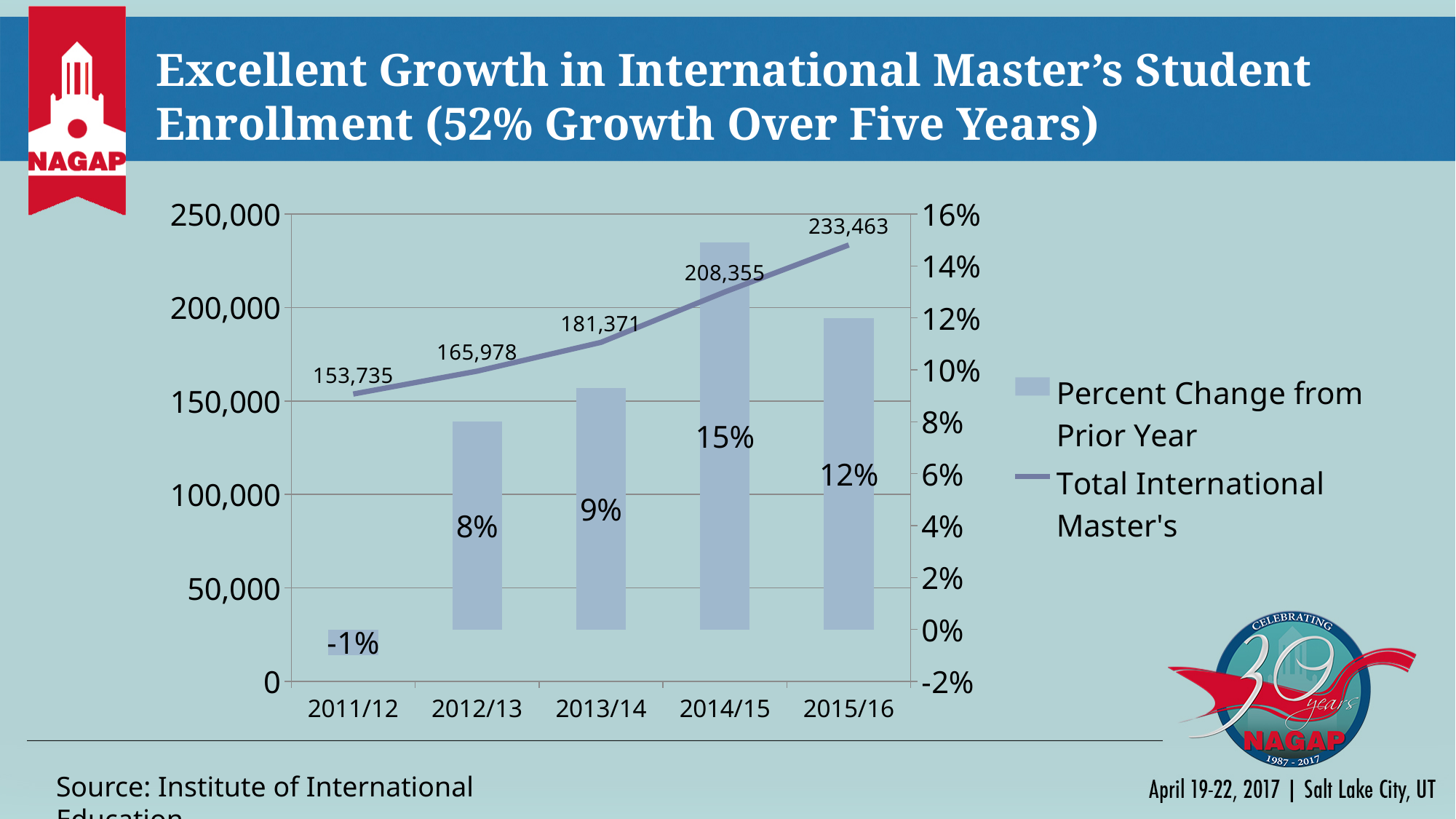
Which year had the lowest Total International Master's enrollment? 2011/12 What was the Total International Master's enrollment in 2011/12? 153,735 How many series does the legend list? 2 What is the difference in Total International Master's enrollment between 2015/16 and 2011/12? 79,728 What was the Percent Change from Prior Year in 2014/15? 15% Does the Total International Master's enrollment rise or fall from 2011/12 to 2015/16? rise Which is larger, the Percent Change from Prior Year in 2013/14 or in 2015/16? 2015/16 Which year had the highest Percent Change from Prior Year? 2014/15 What was the Total International Master's enrollment in 2015/16? 233,463 Which series is shown as a line rather than bars? Total International Master's How many academic years are shown on the x axis? 5 What was the Percent Change from Prior Year in 2011/12? -1%